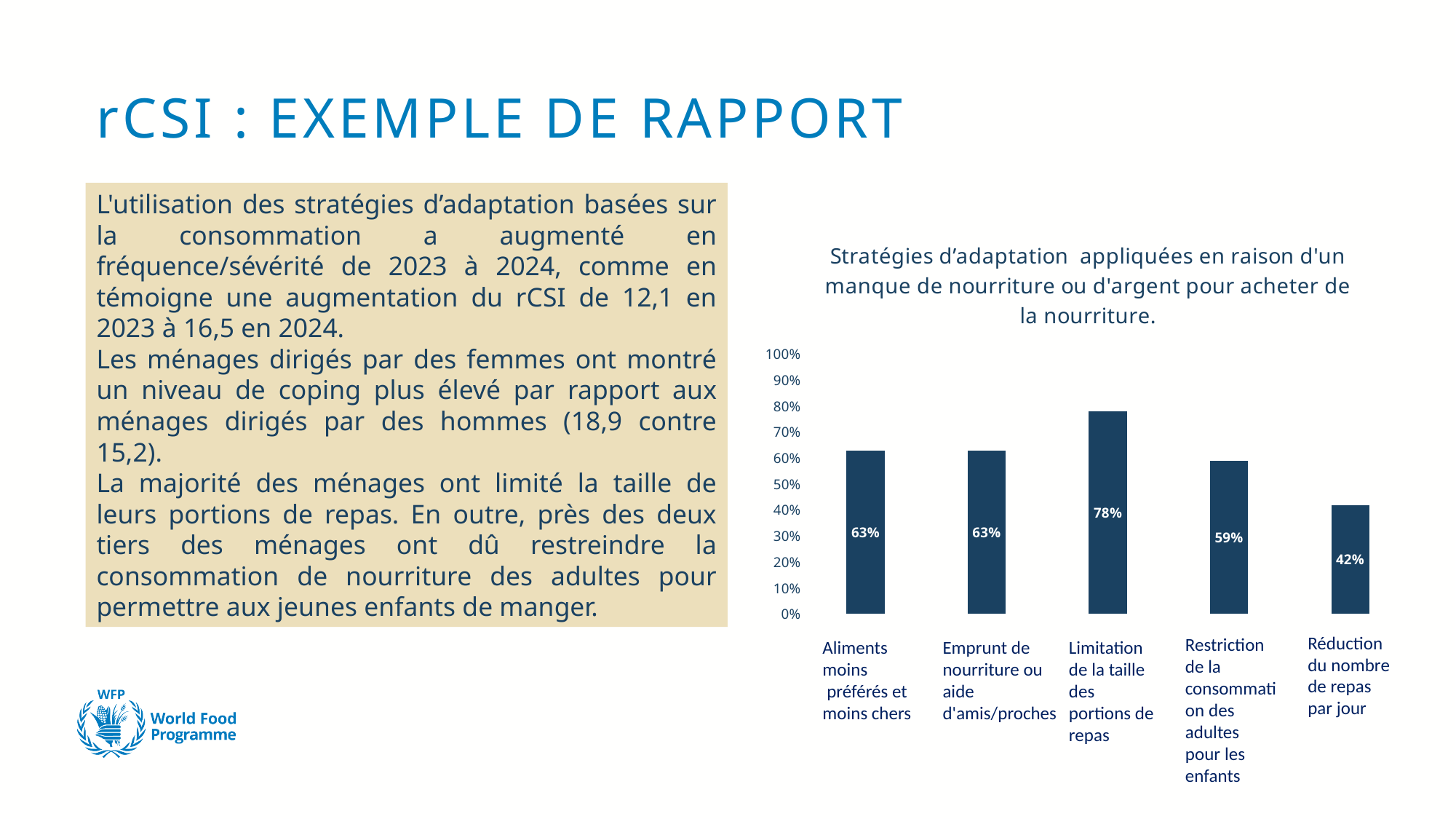
What is the title of the chart? Stratégies d'adaptation appliquées en raison d'un manque de nourriture ou d'argent pour acheter de la nourriture. Which is larger: the value for 'Aliments moins préférés et moins chers' or the value for 'Restriction de la consommation des adultes pour les enfants'? Aliments moins préférés et moins chers Is the value for 'Restriction de la consommation des adultes pour les enfants' greater or less than 50%? greater What is the value for 'Réduction du nombre de repas par jour'? 42% What is the value for 'Emprunt de nourriture ou aide d'amis/proches'? 63% What is the difference between the values for 'Limitation de la taille des portions de repas' and 'Réduction du nombre de repas par jour'? 36% What is the value for 'Limitation de la taille des portions de repas'? 78% What kind of chart is shown on the slide? Bar chart Which category has the lowest value? Réduction du nombre de repas par jour What is the value for 'Restriction de la consommation des adultes pour les enfants'? 59% Which category has the highest value? Limitation de la taille des portions de repas How many categories are shown in the chart? 5